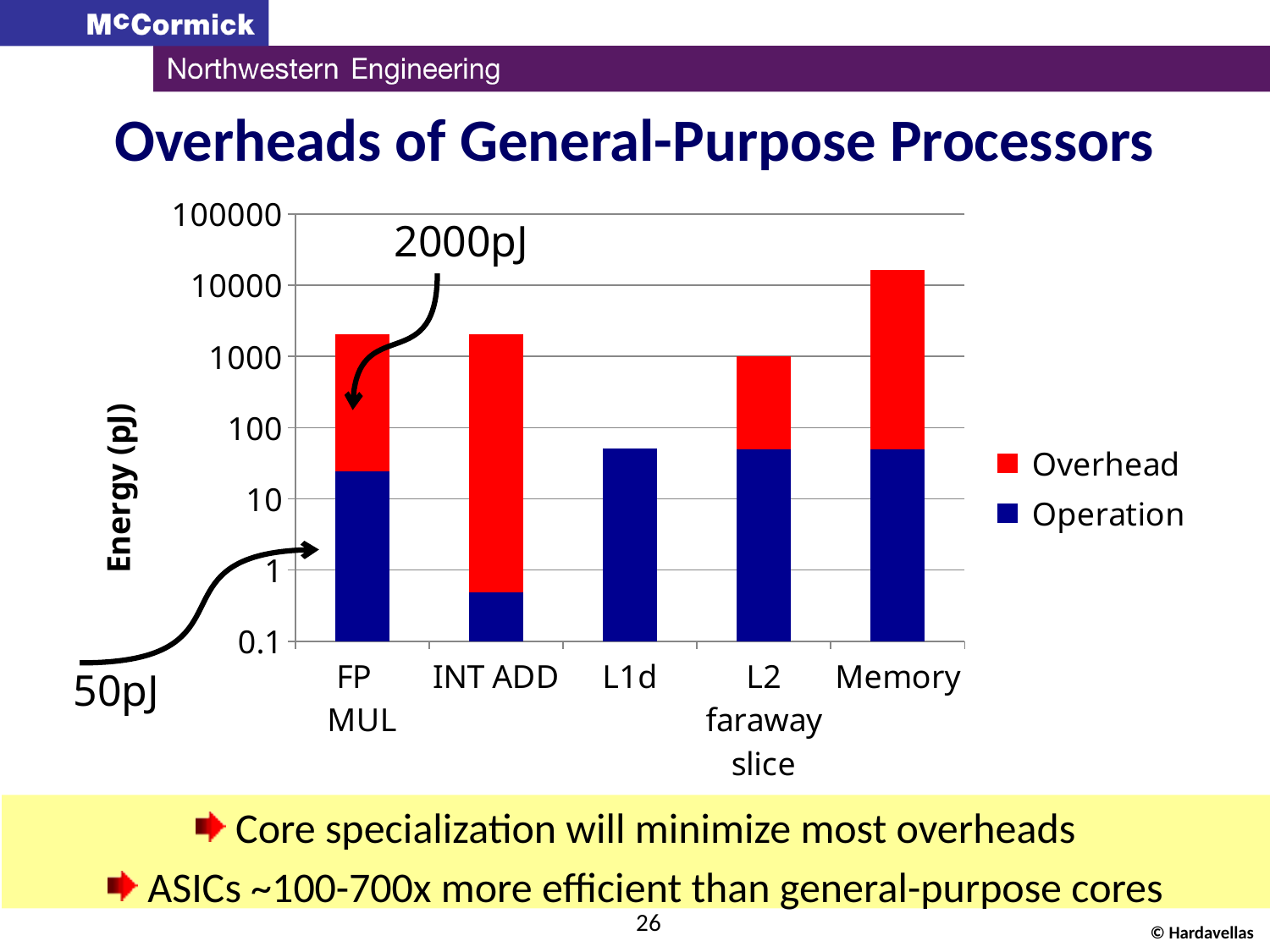
How many categories are shown on the x axis of the chart? 5 How many series does the chart's legend list? 2 Is the value for L1d greater or less than 100? less Which category has the shortest bar in the chart? L1d Which category has the tallest bar in the chart? Memory Is the Operation portion of the INT ADD bar greater or less than 1? less Which category shows no Overhead portion in its bar? L1d Which colour represents the Overhead series in the legend? Red Which bar is taller, Memory or L2 faraway slice? Memory What kind of chart is shown on the slide? Stacked bar chart What is the label of the y axis? Energy (pJ) Is the total value for Memory greater or less than 10000? greater